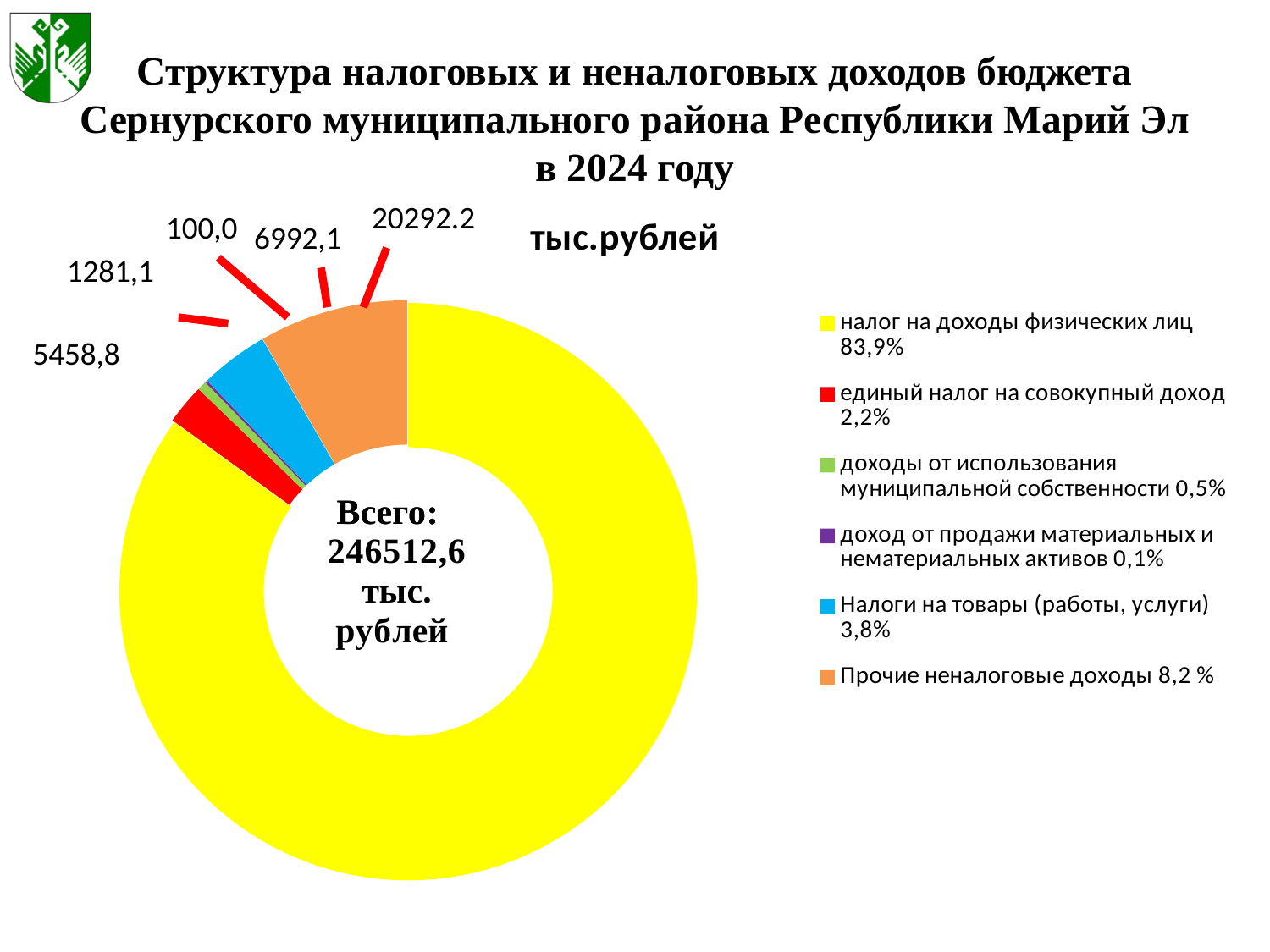
How many categories does the legend of the chart list? 6 What is the value labelled for the "единый налог на совокупный доход" slice (red)? 5458,8 Which is larger: the share of "единый налог на совокупный доход" or the share of "Налоги на товары (работы, услуги)"? Налоги на товары (работы, услуги) What is the total value shown in the centre of the chart? 246512,6 тыс. рублей What share of the chart does "Налоги на товары (работы, услуги)" account for? 3,8% Which category has the smallest share of the chart? доход от продажи материальных и нематериальных активов What is the value labelled for the "Налоги на товары (работы, услуги)" slice (blue)? 6992,1 What is the value labelled for the "Прочие неналоговые доходы" slice (orange)? 20292.2 What kind of chart is shown on the slide? pie chart (donut) What share of the chart does "налог на доходы физических лиц" account for? 83,9% What share of the chart does "Прочие неналоговые доходы" account for? 8,2 % Which category has the largest share of the chart? налог на доходы физических лиц